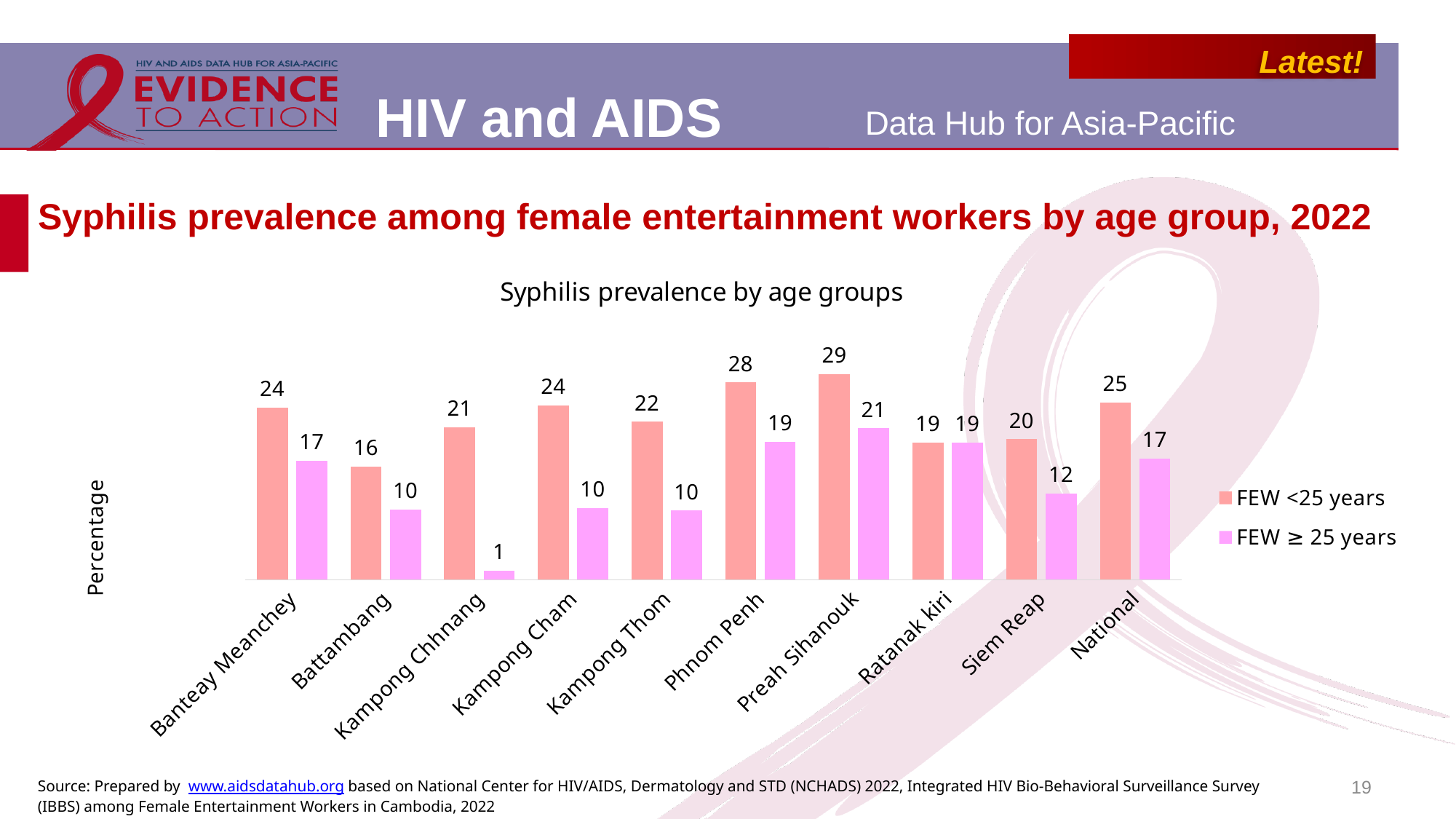
What is the label on the vertical axis? Percentage How many categories are shown on the x axis? 10 What is the title of the chart? Syphilis prevalence by age groups Which category has the highest value for FEW <25 years? Preah Sihanouk What is the National value for FEW ≥ 25 years? 17 How many series does the legend list? 2 What is the value for FEW ≥ 25 years in Kampong Chhnang? 1 Which category has the lowest value for FEW ≥ 25 years? Kampong Chhnang What kind of chart is shown on the slide? Bar chart Which is larger in Siem Reap: the FEW <25 years value or the FEW ≥ 25 years value? FEW <25 years What is the difference between the FEW <25 years and FEW ≥ 25 years values in Kampong Cham? 14 What is the value for FEW <25 years in Phnom Penh? 28